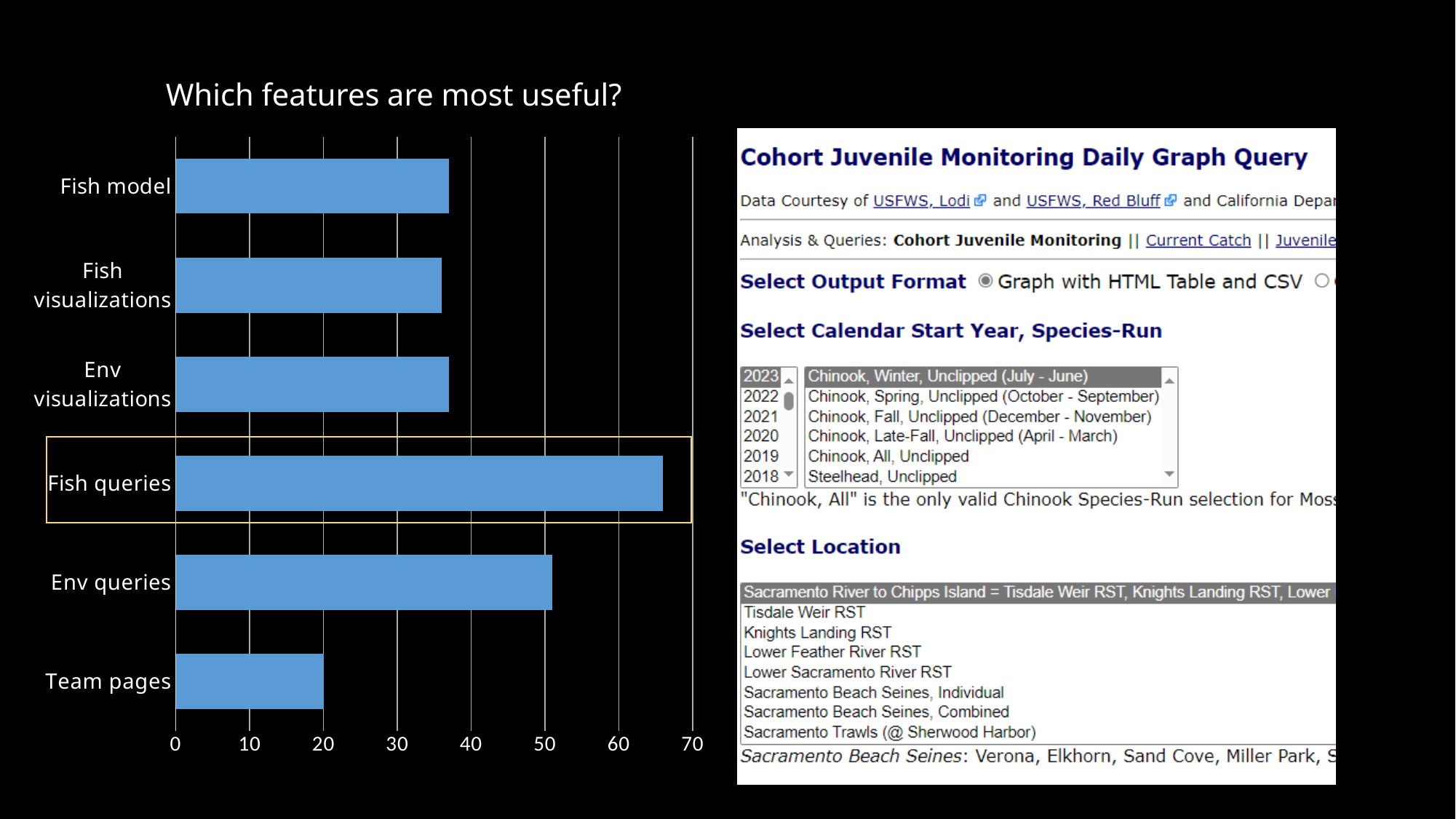
Is the value for Fish queries greater or less than 60? greater Which category has the highest value? Fish queries Which category has the lowest value? Team pages How many categories are shown in the chart? 6 Is the value for Env queries greater or less than 40? greater Which is larger, the value for Fish queries or the value for Env queries? Fish queries Which category's bar is outlined with a highlight box on the chart? Fish queries Is the value for Team pages greater or less than 30? less What kind of chart is shown on the slide? bar chart Which is larger, the value for Env queries or the value for Fish model? Env queries What is the title of the chart? Which features are most useful?